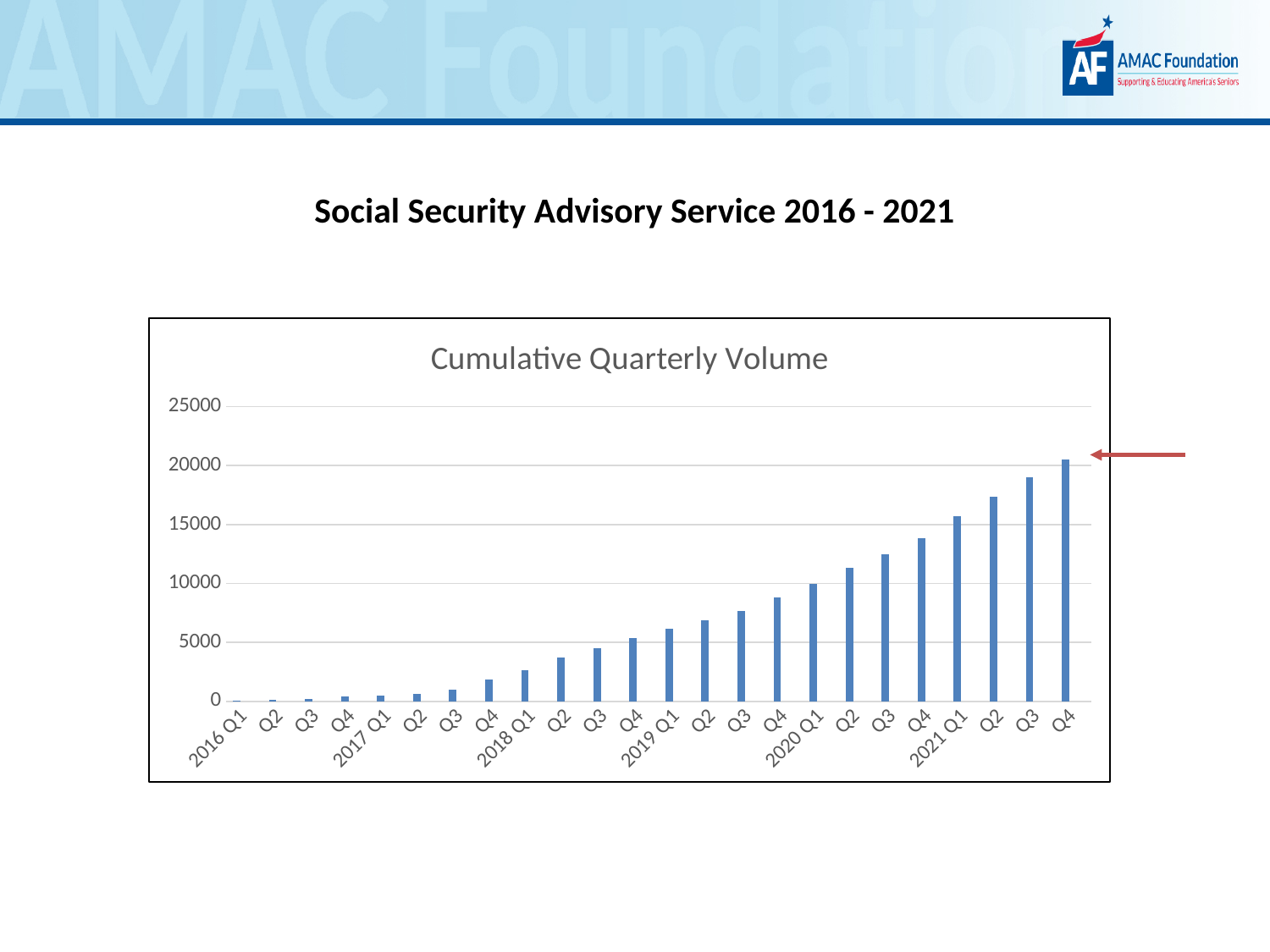
What is the title of the chart? Cumulative Quarterly Volume Which quarter has the lowest cumulative volume? 2016 Q1 Is the value for 2021 Q4 greater or less than 15000? greater What kind of chart is shown on the slide? Bar chart Is the value for 2021 Q3 greater or less than 20000? less Which is larger, the value for 2021 Q3 or the value for 2020 Q3? 2021 Q3 Which quarter has the highest cumulative volume? 2021 Q4 How many quarterly bars are plotted in the chart? 24 Is the value for 2020 Q4 greater or less than 15000? less Do the values rise or fall from 2016 Q1 to 2021 Q4? Rise